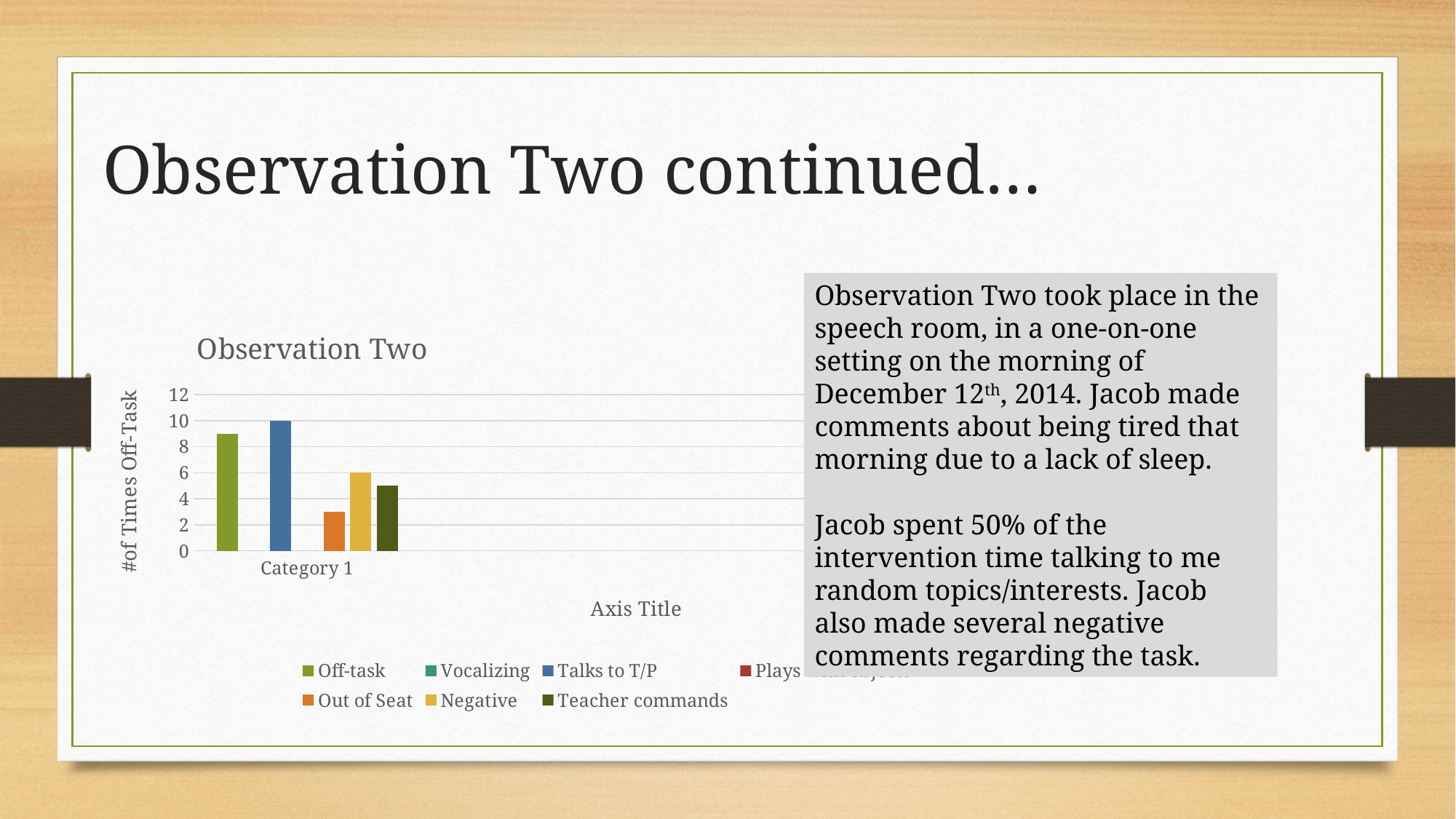
Which series has the tallest bar in the chart? Talks to T/P What is the difference between the values for Talks to T/P and Negative? 4 What kind of chart is shown on the slide? bar chart How many series does the chart's legend list? 7 What is the value for Negative in Category 1? 6 How many categories are shown on the x axis of the chart? 1 What is the label on the vertical axis of the chart? #of Times Off-Task What is the title of the chart? Observation Two Among the bars visible in the chart, which series has the shortest bar? Out of Seat Is the value for Out of Seat greater or less than 4? less What is the value for Talks to T/P in Category 1? 10 Which is larger, the value for Off-task or the value for Negative? Off-task